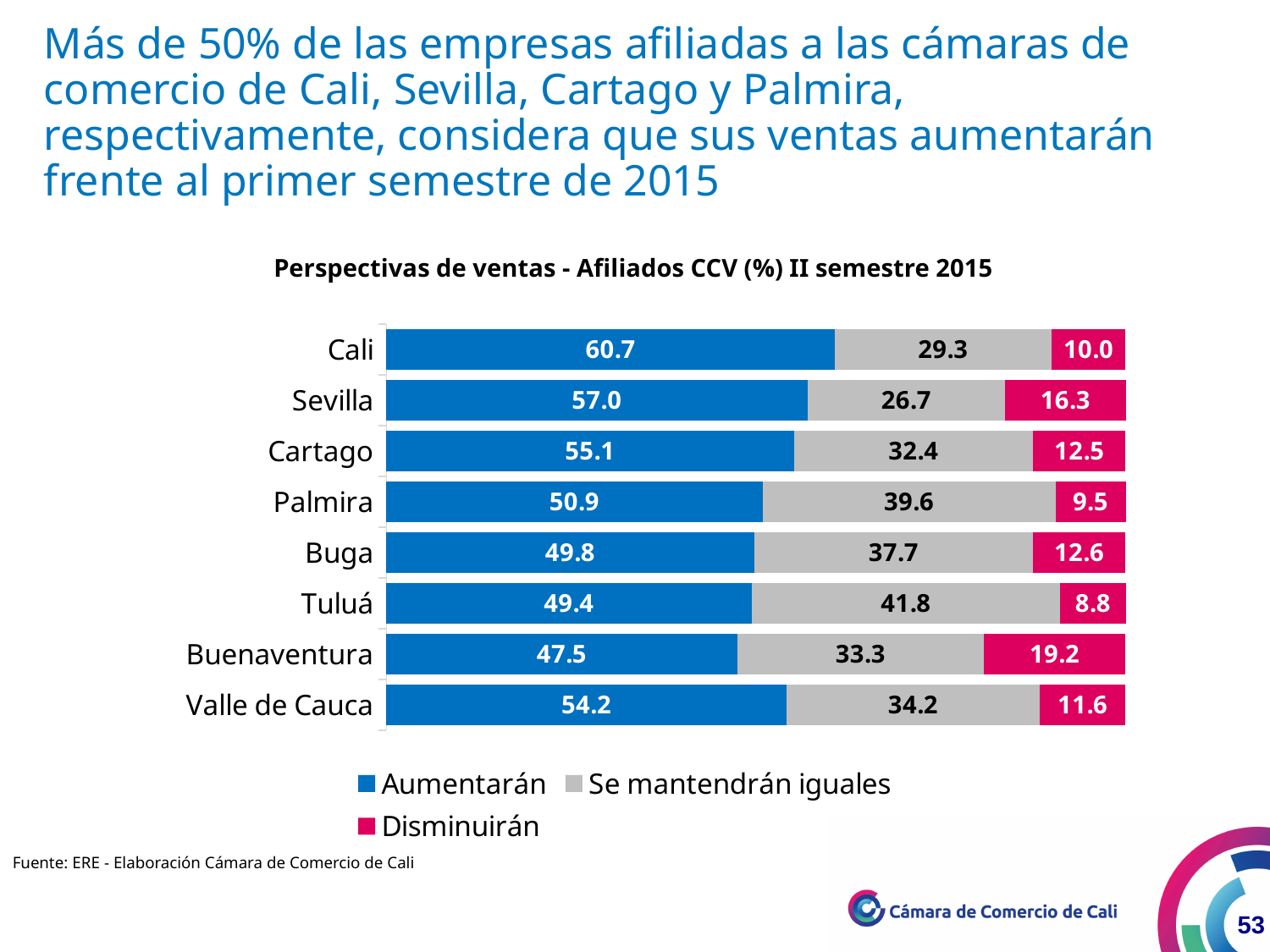
What is the total of the stacked bar for Sevilla? 100.0 What is the title of the chart? Perspectivas de ventas - Afiliados CCV (%) II semestre 2015 What is the 'Disminuirán' value for Buenaventura? 19.2 What is the 'Se mantendrán iguales' value for Palmira? 39.6 Which category has the lowest 'Disminuirán' value? Tuluá What is the 'Aumentarán' value for Cali? 60.7 How many categories are shown on the chart? 8 How many series does the legend list? 3 What kind of chart is shown on the slide? Stacked bar chart What is the difference between the 'Aumentarán' values for Cali and Buenaventura? 13.2 Which category has the highest 'Aumentarán' value? Cali Which is larger, the 'Se mantendrán iguales' value for Tuluá or for Cartago? Tuluá